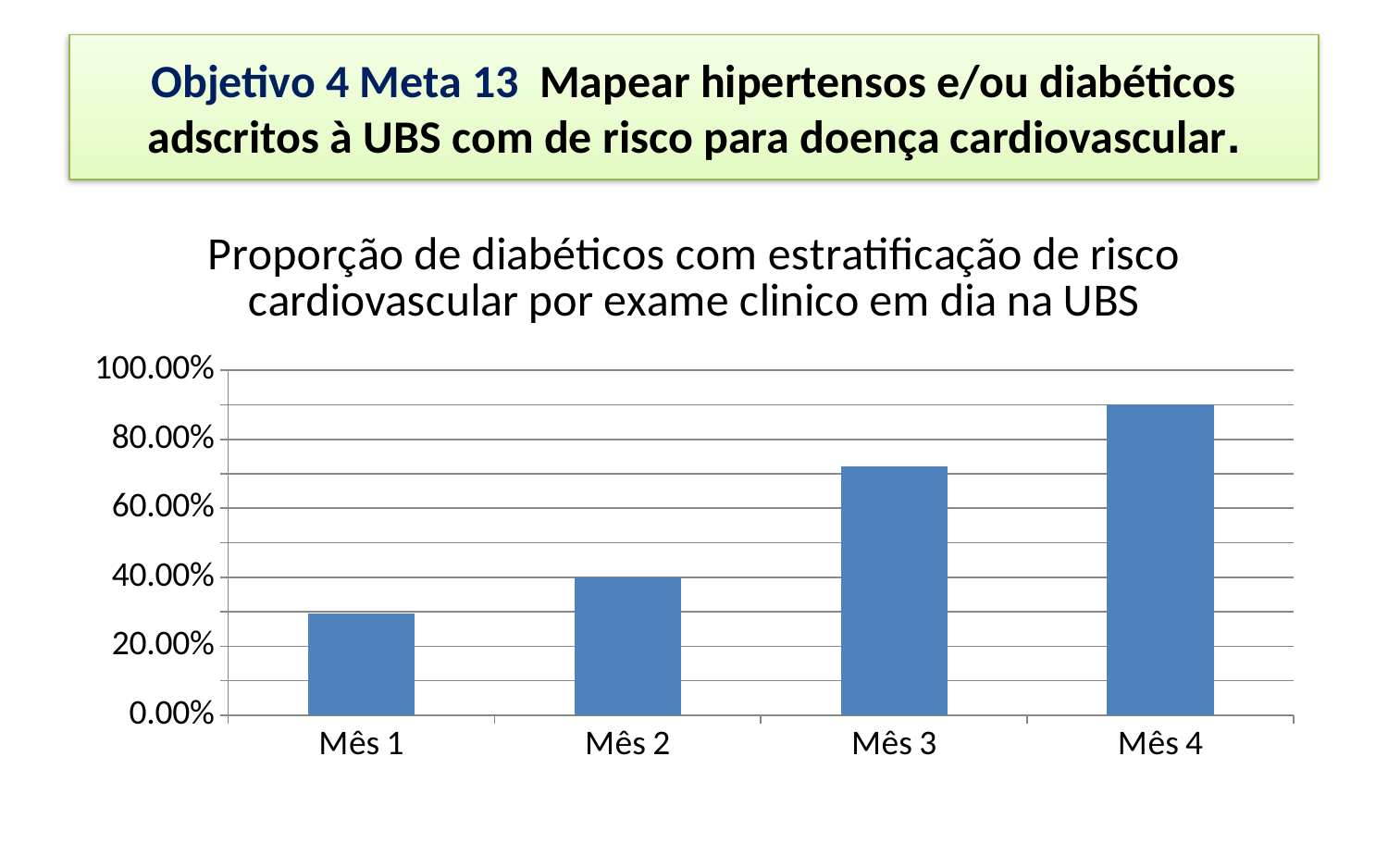
What kind of chart is shown on the slide? bar chart Is the value for Mês 4 greater or less than 80.00%? greater Which is larger, the value for Mês 2 or the value for Mês 3? Mês 3 Is the value for Mês 3 greater or less than 60.00%? greater What is the highest value shown on the vertical axis? 100.00% Do the values rise or fall from Mês 1 to Mês 4? rise Which month has the lowest proportion? Mês 1 Is the value for Mês 2 greater or less than 60.00%? less What is the title of the chart? Proporção de diabéticos com estratificação de risco cardiovascular por exame clinico em dia na UBS Which month has the highest proportion? Mês 4 How many categories (months) are plotted on the chart? 4